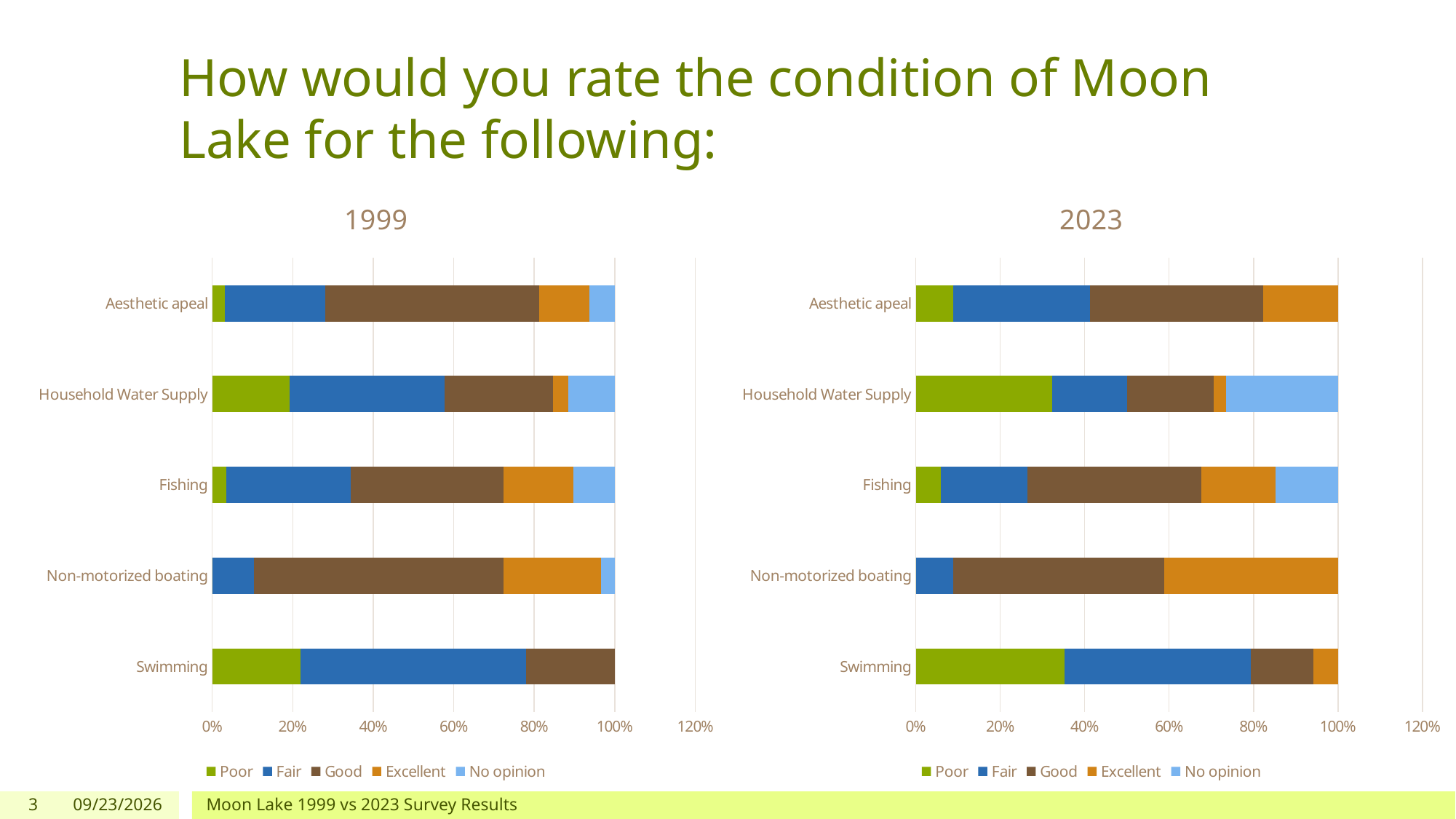
In the 2023 chart, which series is shown in green? Poor In the 1999 chart, is the Fair share for Swimming greater or less than 40%? greater In the 2023 chart, is the Excellent share for Non-motorized boating greater or less than 20%? greater What kind of chart is the 1999 chart on the left? stacked bar chart What are the titles of the two charts on the slide? 1999 and 2023 In the 1999 chart, is the Poor share for Fishing greater or less than 20%? less In the 1999 chart, which category has the largest Good share? Non-motorized boating In the 1999 chart, which category has the smallest Poor share? Non-motorized boating In the 2023 chart, which has the larger Poor share: Swimming or Fishing? Swimming How many categories are shown on the 2023 chart? 5 How many series does the legend of the 1999 chart list? 5